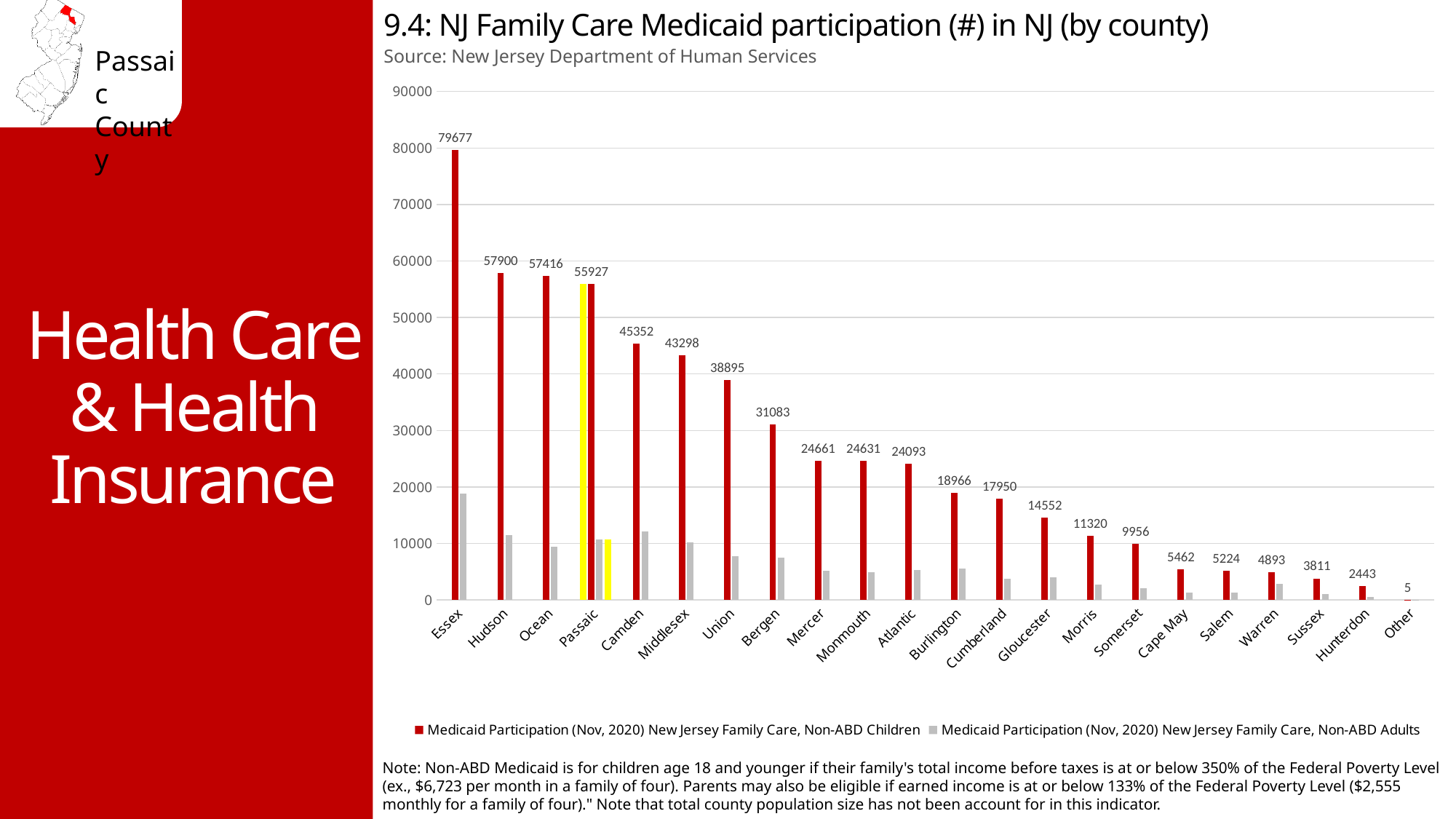
Is the Non-ABD Adults value for Essex greater or less than 10000? greater Which county has the highest Non-ABD Children Medicaid participation? Essex Is the Non-ABD Adults value for Morris greater or less than 10000? less Which has a larger Non-ABD Children value, Camden or Union? Camden What is the Non-ABD Children Medicaid participation value for Essex? 79677 Which category has the lowest Non-ABD Children Medicaid participation? Other What is the Non-ABD Children Medicaid participation value for Passaic? 55927 What is the Non-ABD Children Medicaid participation value for Bergen? 31083 How many categories are shown on the x axis? 22 What is the difference between the Non-ABD Children values for Hudson and Ocean? 484 How many series does the legend list? 2 What kind of chart is shown on the slide? Bar chart